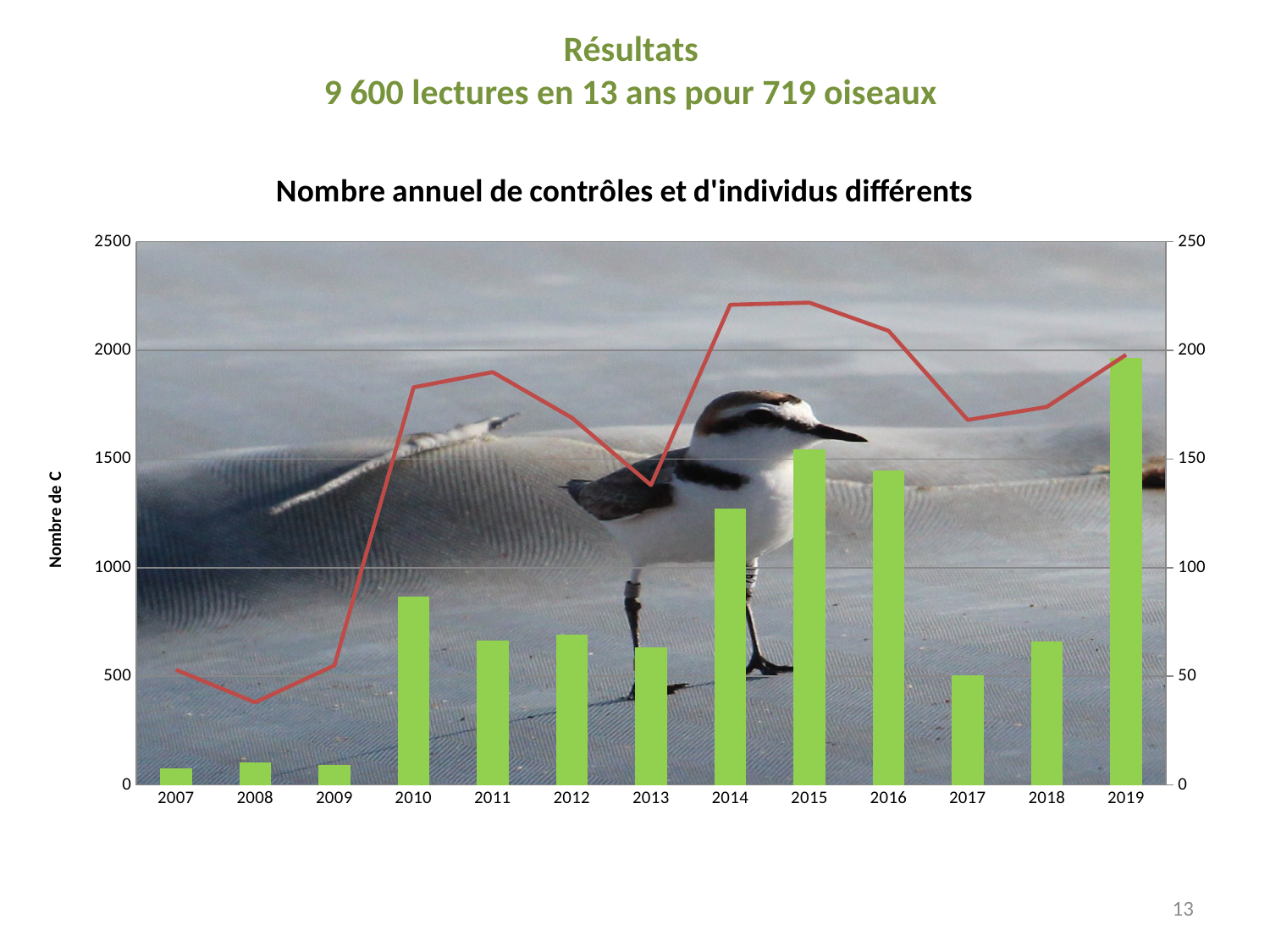
Is the green bar for 2019 greater or less than 1500 on the left axis? greater Is the green bar for 2010 greater or less than 1000 on the left axis? less Is the green bar for 2008 greater or less than 500 on the left axis? less Which year has the tallest green bar? 2019 What is the title of the chart? Nombre annuel de contrôles et d'individus différents Which green bar is taller, 2015 or 2016? 2015 Which year has the shortest green bar? 2007 What kind of chart is shown on the slide? A combined bar and line chart How many years are shown on the x axis of the chart? 13 Which year has the lowest point on the red line? 2008